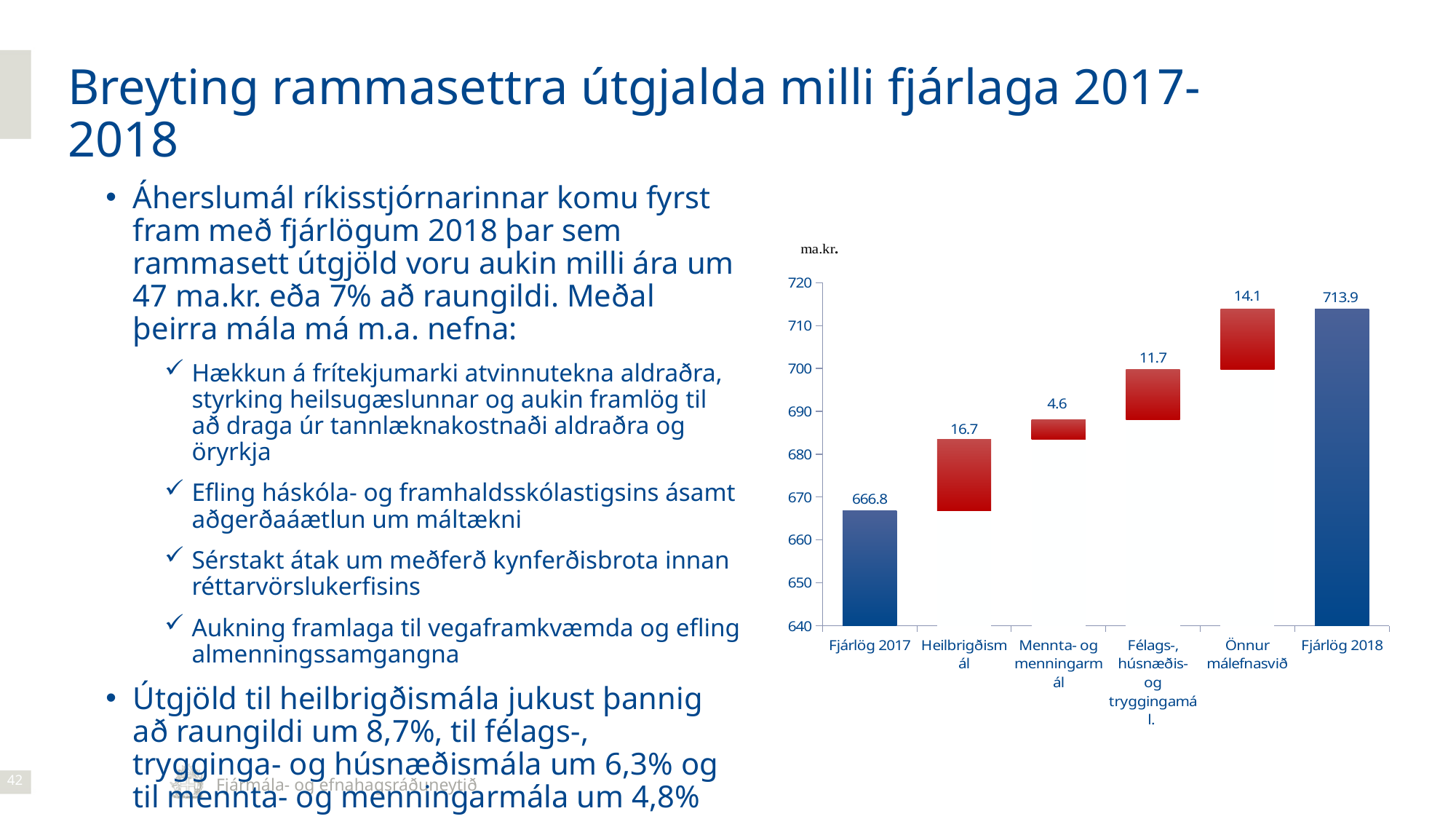
Among the four red increment bars, which category has the smallest labelled value? Mennta- og menningarmál Among the four red increment bars, which category has the largest labelled value? Heilbrigðismál What is the value shown for Fjárlög 2018? 713.9 How many categories are shown on the x axis of the chart? 6 What unit label is shown above the vertical axis of the chart? ma.kr. What is the value labelled on the Heilbrigðismál bar? 16.7 What is the difference between the Fjárlög 2018 value and the Fjárlög 2017 value? 47.1 What is the value labelled on the Önnur málefnasvið bar? 14.1 What is the value shown for Fjárlög 2017? 666.8 Which has a larger labelled value, Félags-, húsnæðis- og tryggingamál or Önnur málefnasvið? Önnur málefnasvið What is the value labelled on the Mennta- og menningarmál bar? 4.6 Is the value for Fjárlög 2018 greater or less than 700? greater